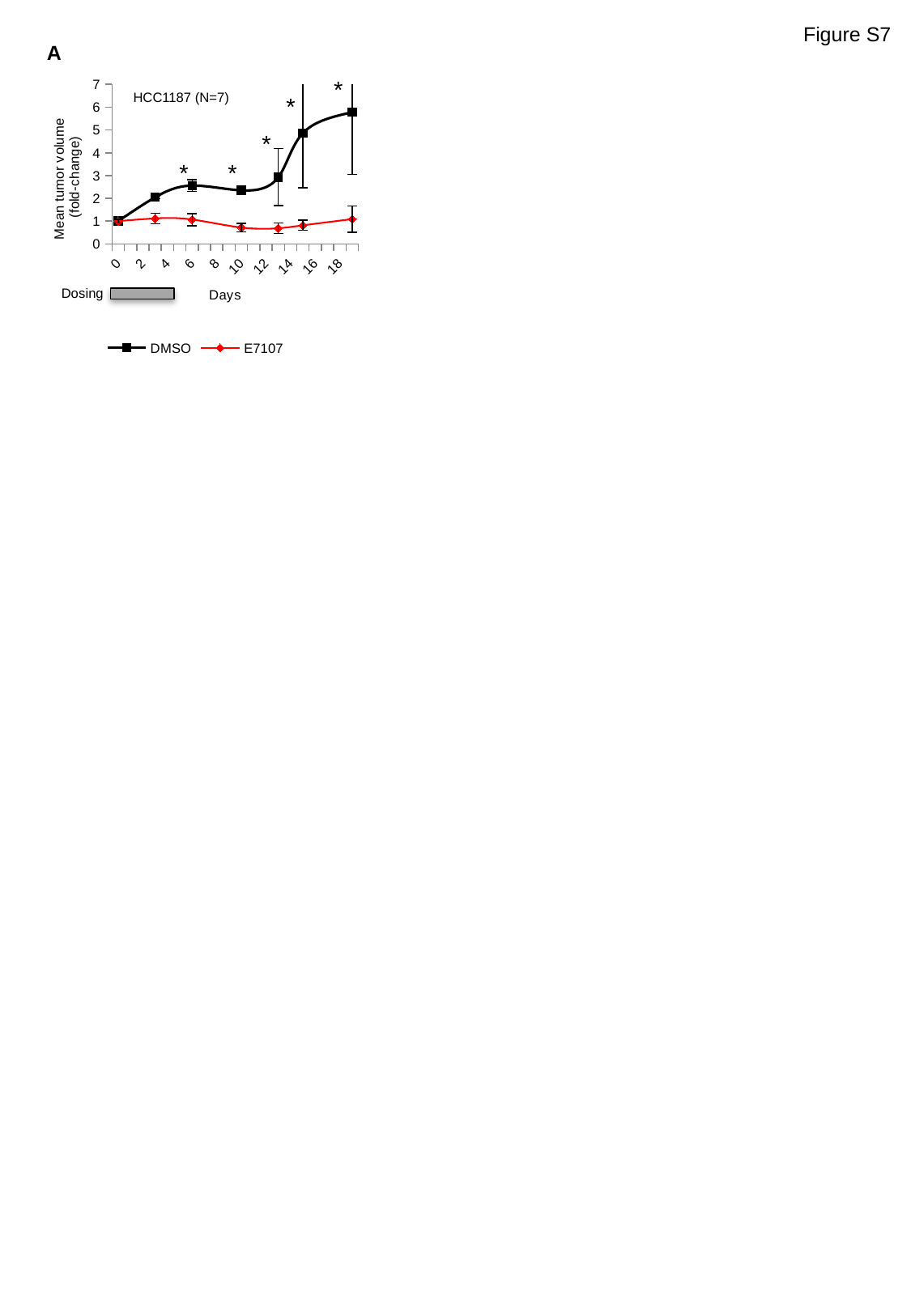
At day 19, which series has the larger mean tumor volume, DMSO or E7107? DMSO Does the DMSO series generally rise or fall from day 0 to day 19? rise How many series does the legend list? 2 Is the DMSO value at day 6 greater or less than 2? greater How many data points are plotted for the DMSO series? 7 Is the DMSO value at day 19 greater or less than 5? greater What are the two series named in the legend? DMSO and E7107 Is the DMSO value at day 15 greater or less than 4? greater What is the label printed inside the plot area of the chart? HCC1187 (N=7) Which series reaches the highest mean tumor volume on the chart? DMSO What kind of chart is shown on the slide? line chart